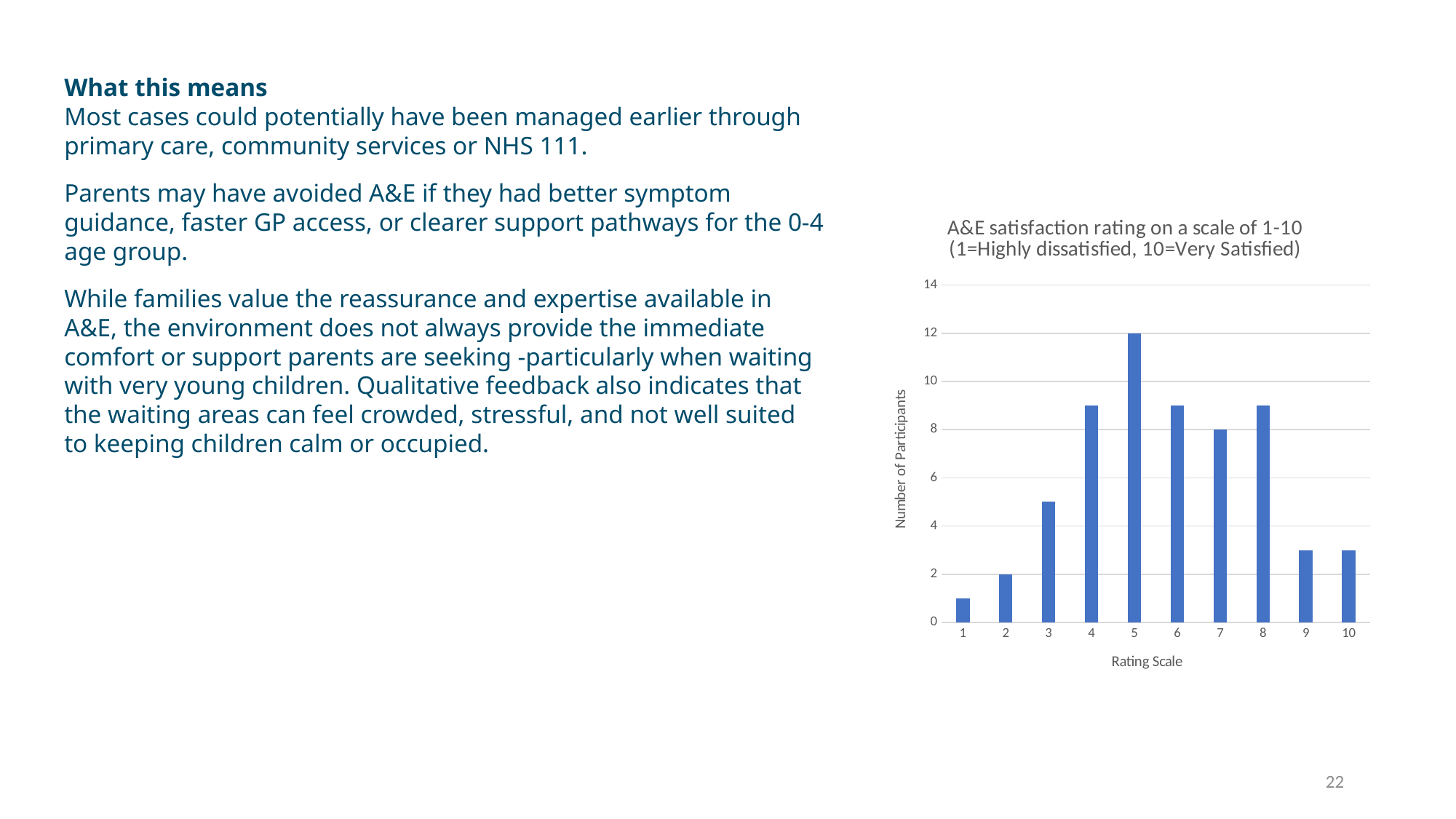
How many participants gave a rating of 5? 12 How many participants gave a rating of 7? 8 Is the number of participants who gave a rating of 3 greater or less than 4? greater Which rating received the highest number of participants? 5 Which rating received the lowest number of participants? 1 Is the number of participants who gave a rating of 9 greater or less than 4? less What type of chart is shown on the slide? bar chart What is the difference between the number of participants who gave a rating of 5 and those who gave a rating of 7? 4 How many participants gave a rating of 2? 2 Which rating had more participants, 3 or 9? 3 How many rating categories are shown on the x axis of the chart? 10 What is the label of the y axis of the chart? Number of Participants